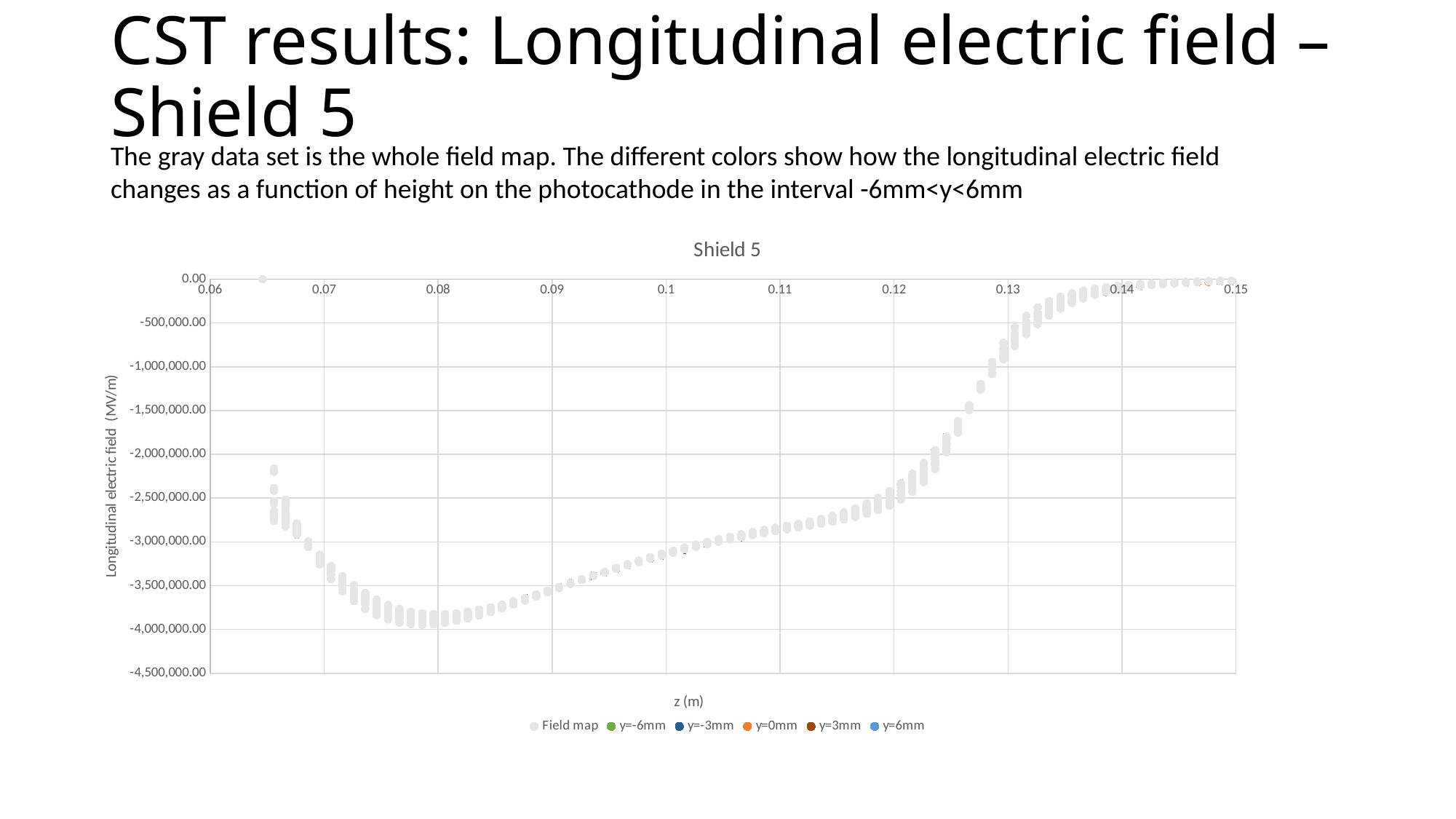
How many series does the legend of the Shield 5 chart list? 6 Do the Field map values rise or fall as z increases from 0.08 to 0.15? rise Is the Field map value at z = 0.1 greater or less than -3,500,000.00? greater What is the lowest tick value shown on the y axis? -4,500,000.00 Between which two x-axis ticks does the Field map reach its lowest value? 0.07 and 0.08 What is the title of the chart? Shield 5 What is the label of the x axis of the chart? z (m) Is the Field map value at z = 0.14 greater or less than -500,000.00? greater Is the Field map value at z = 0.07 greater or less than -2,500,000.00? less Which is larger, the Field map value at z = 0.08 or at z = 0.12? z = 0.12 What kind of chart is shown on the slide? scatter chart